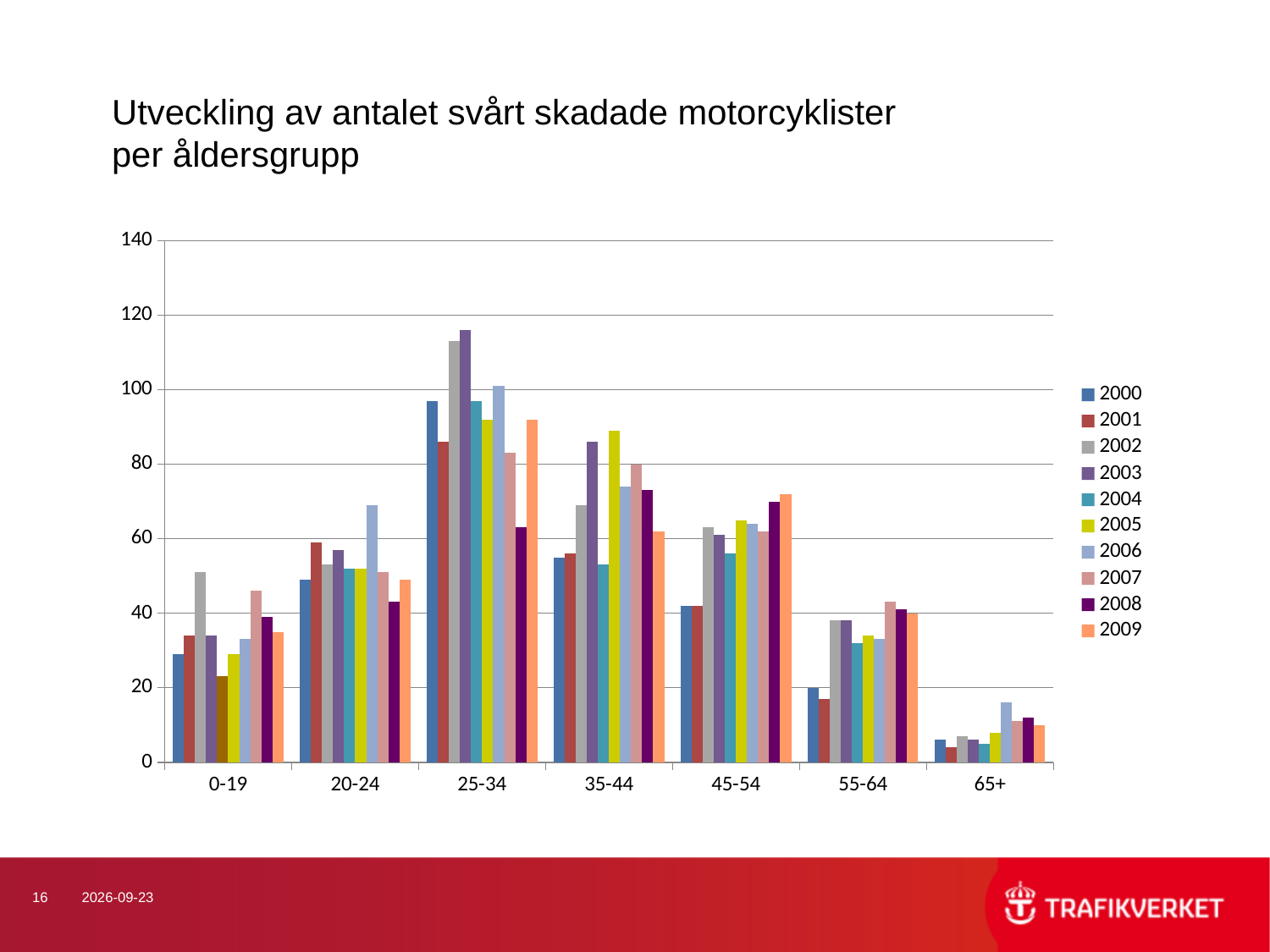
Which age group has the highest values across the series? 25-34 What is the title of the chart on the slide? Utveckling av antalet svårt skadade motorcyklister per åldersgrupp Which age group has the lowest values across the series? 65+ Is the value for 2009 in the 25-34 age group greater or less than 100? less Is the value for 2003 in the 25-34 age group greater or less than 100? greater How many series does the legend list? 10 What kind of chart is shown on the slide? bar chart Is the value for 2001 in the 55-64 age group greater or less than 20? less In the 0-19 age group, which is larger: the value for 2002 or the value for 2000? 2002 Do the values for 2009 rise or fall from the 45-54 age group to the 65+ age group? fall How many age groups are shown on the x axis? 7